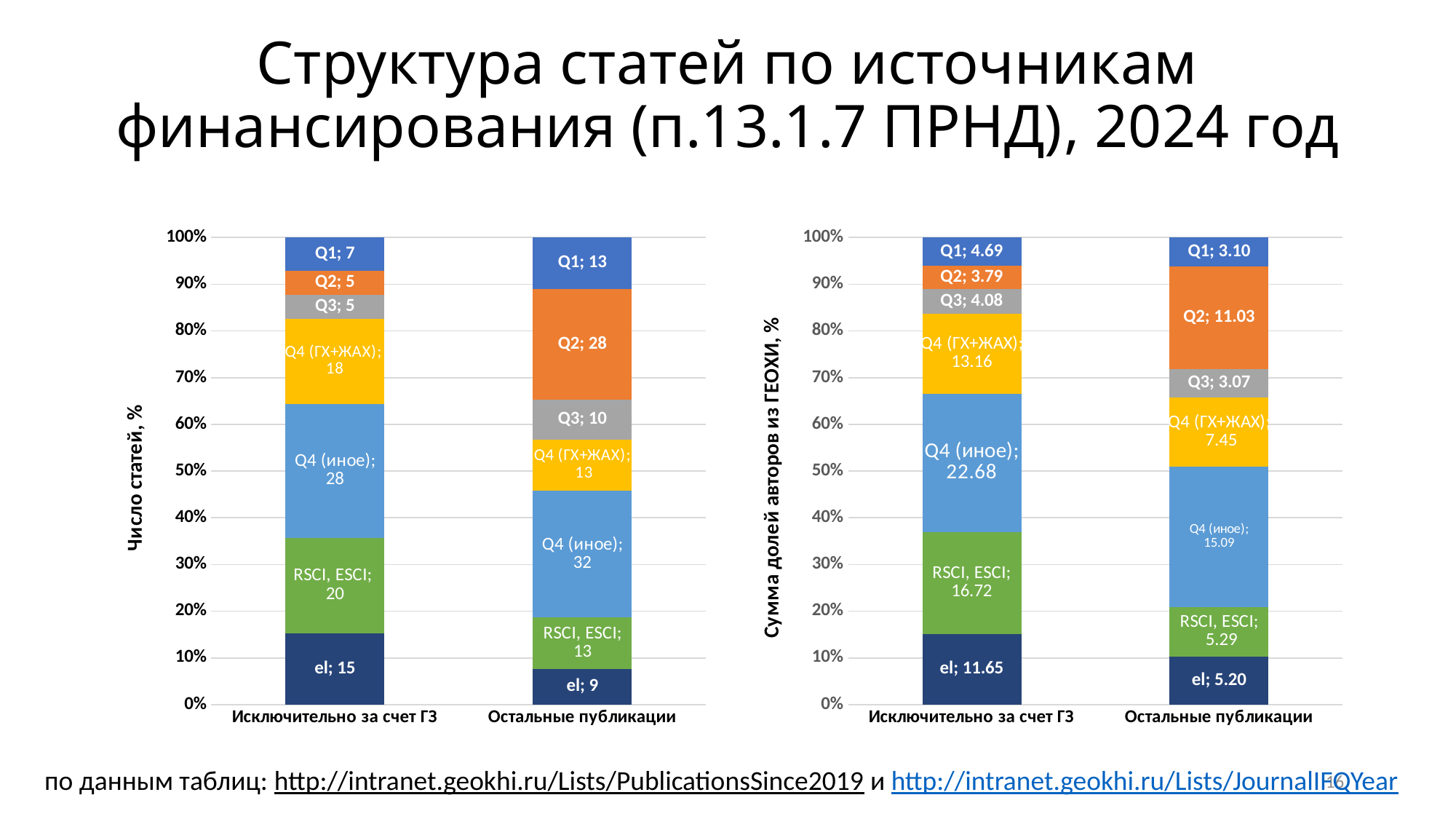
In the left chart (Число статей, %), what is the value of the Q4 (иное) segment for Исключительно за счет ГЗ? 28 In the left chart (Число статей, %), which segment is the largest in the Остальные публикации bar? Q4 (иное) How many bars (categories) are shown in the left chart (Число статей, %)? 2 In the left chart (Число статей, %), what is the difference between the Q2 values for Остальные публикации and Исключительно за счет ГЗ? 23 In the right chart (Сумма долей авторов из ГЕОХИ, %), what is the value of the Q2 segment for Остальные публикации? 11.03 What type of chart is the right chart (Сумма долей авторов из ГЕОХИ, %)? Stacked bar chart In the left chart (Число статей, %), what is the value of the Q2 segment for Остальные публикации? 28 In the right chart (Сумма долей авторов из ГЕОХИ, %), what is the value of the eI segment for Исключительно за счет ГЗ? 11.65 In the right chart (Сумма долей авторов из ГЕОХИ, %), which is larger: the RSCI, ESCI value for Исключительно за счет ГЗ or for Остальные публикации? Исключительно за счет ГЗ In the right chart (Сумма долей авторов из ГЕОХИ, %), what is the total of all segments in the Остальные публикации bar? 50.23 In the left chart (Число статей, %), what is the total of all segments in the Исключительно за счет ГЗ bar? 98 In the right chart (Сумма долей авторов из ГЕОХИ, %), which segment is the smallest in the Остальные публикации bar? Q3